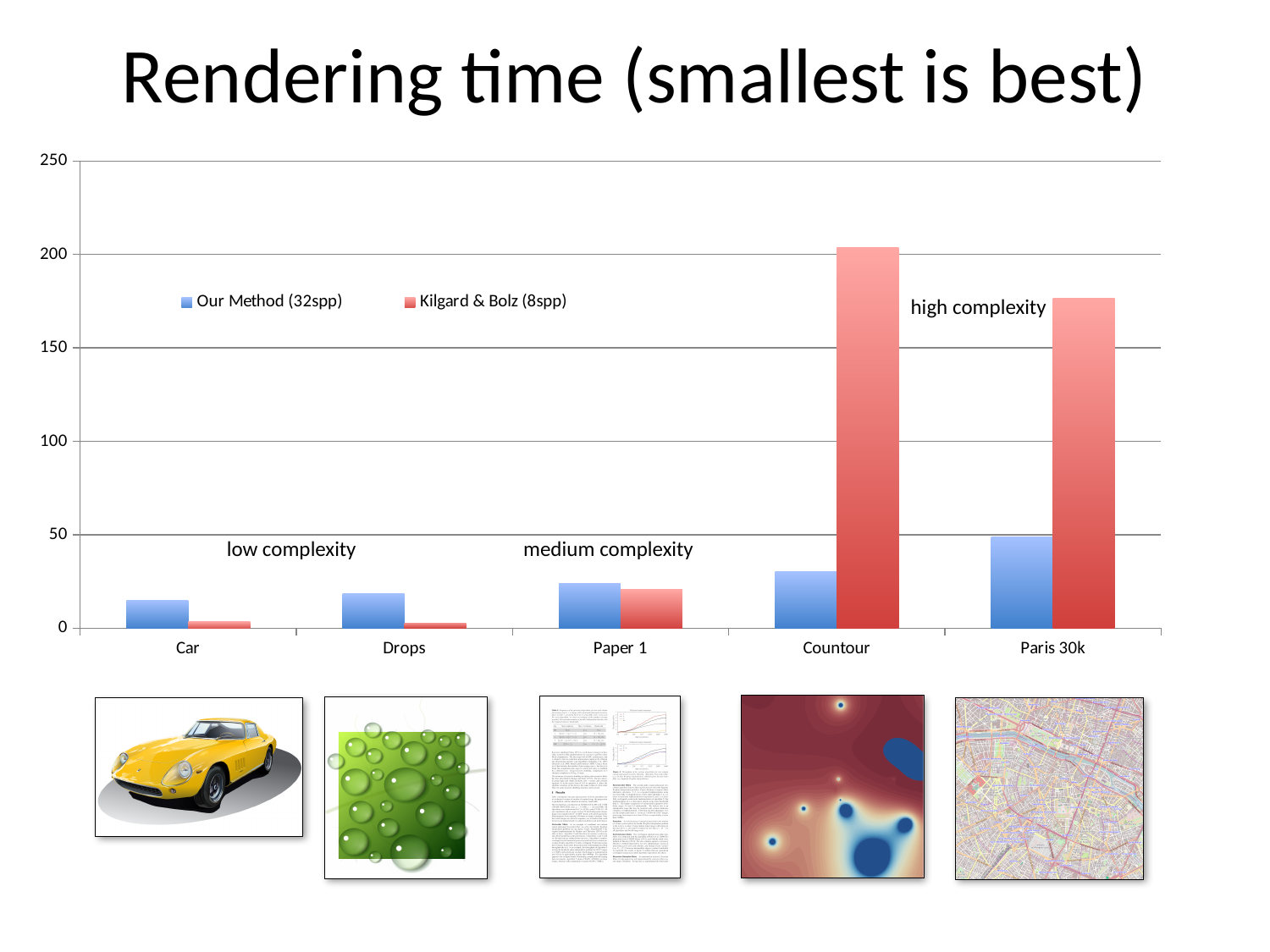
How many categories are shown on the x axis? 5 For Countour, which series has the larger value, Our Method (32spp) or Kilgard & Bolz (8spp)? Kilgard & Bolz (8spp) What kind of chart is shown on the slide? bar chart What is the title of the chart? Rendering time (smallest is best) Is the Kilgard & Bolz (8spp) value for Countour greater or less than 150? greater Is the Our Method (32spp) value for Countour greater or less than 50? less For Car, which series has the larger value, Our Method (32spp) or Kilgard & Bolz (8spp)? Our Method (32spp) Which series is drawn in red? Kilgard & Bolz (8spp) For which category is the Kilgard & Bolz (8spp) value highest? Countour For which category is the Our Method (32spp) value highest? Paris 30k How many series does the legend list? 2 Is the Kilgard & Bolz (8spp) value for Paris 30k greater or less than 200? less